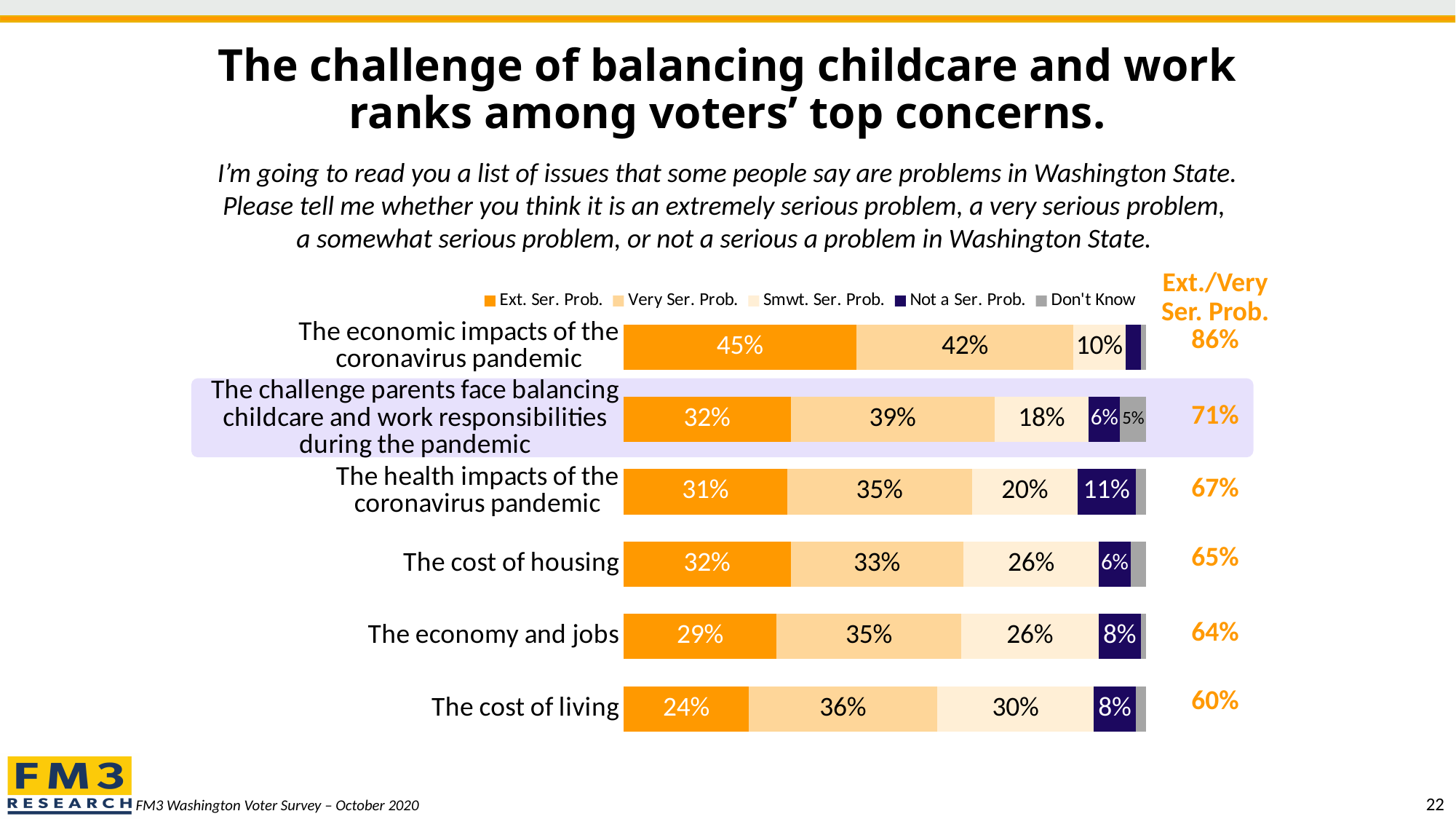
What is the difference in the Ext./Very Ser. Prob. figure between the economic impacts of the coronavirus pandemic and the cost of living? 26 percentage points What is the Don't Know value shown for the challenge parents face balancing childcare and work responsibilities during the pandemic? 5% What is the combined Ext./Very Ser. Prob. figure for the challenge parents face balancing childcare and work responsibilities during the pandemic? 71% Which issue has the lowest combined Ext./Very Ser. Prob. figure? The cost of living Which issue has the highest Ext. Ser. Prob. percentage? The economic impacts of the coronavirus pandemic What type of chart is shown on the slide? Stacked bar chart How many response categories does the legend list? 5 What percentage of voters rated the economic impacts of the coronavirus pandemic as an extremely serious problem (Ext. Ser. Prob.)? 45% Which issue is highlighted with a shaded background on the slide? The challenge parents face balancing childcare and work responsibilities during the pandemic What is the Very Ser. Prob. value for the cost of living? 36% How many issues are listed in the chart? 6 Which has a larger Not a Ser. Prob. share: the health impacts of the coronavirus pandemic or the cost of housing? The health impacts of the coronavirus pandemic